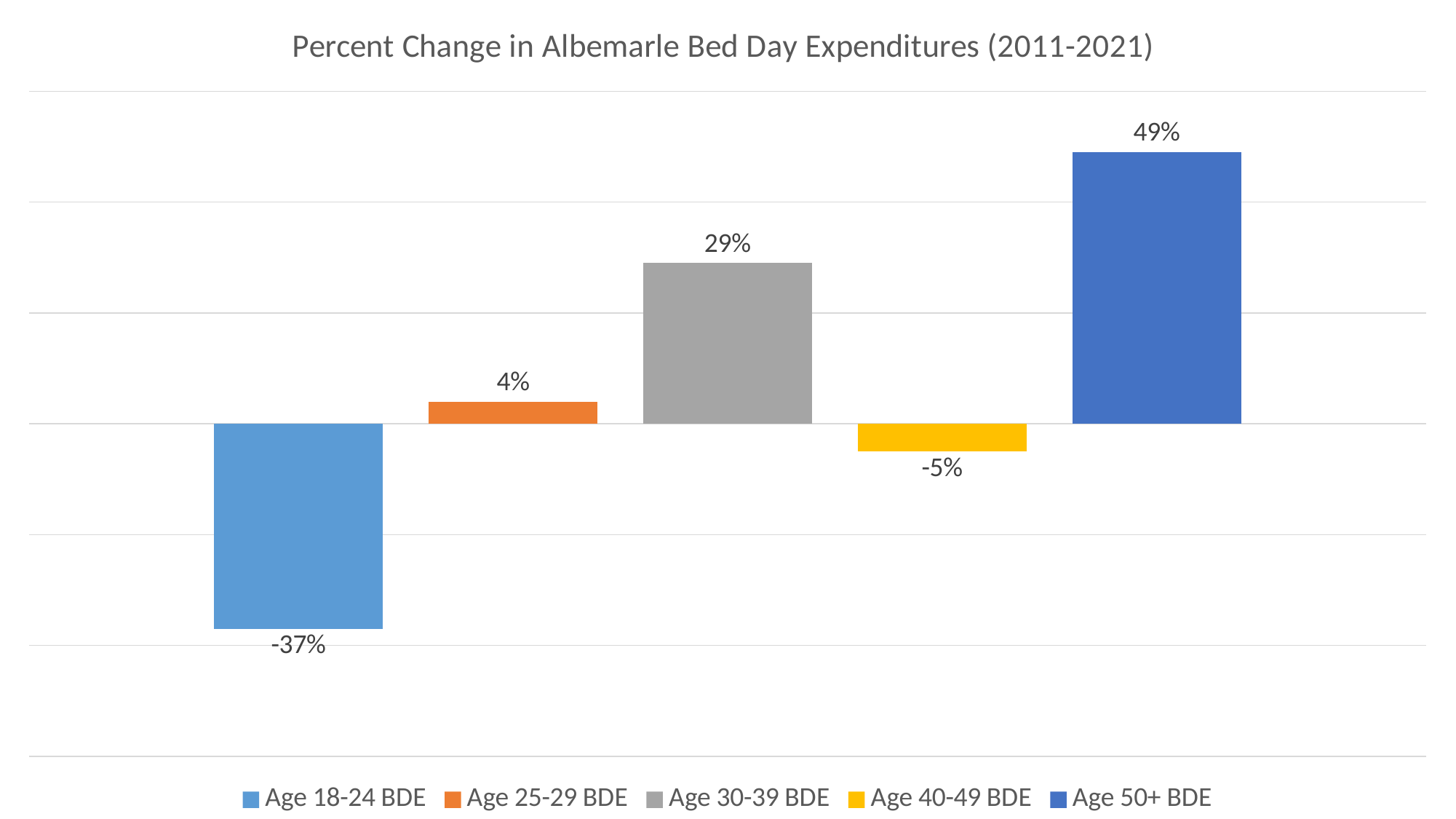
What is the percent change in bed day expenditures for Age 50+ BDE? 49% What is the percent change in bed day expenditures for Age 30-39 BDE? 29% How many age groups are shown in the chart? 5 Which has a larger percent change, Age 25-29 BDE or Age 30-39 BDE? Age 30-39 BDE What is the title of the chart? Percent Change in Albemarle Bed Day Expenditures (2011-2021) What is the percent change in bed day expenditures for Age 18-24 BDE? -37% What type of chart is shown on the slide? Bar chart Which age group has the lowest percent change in bed day expenditures? Age 18-24 BDE What is the percent change in bed day expenditures for Age 40-49 BDE? -5% Which age group has the highest percent change in bed day expenditures? Age 50+ BDE How many entries does the legend list? 5 What is the difference between the percent change for Age 50+ BDE and Age 30-39 BDE? 20 percentage points